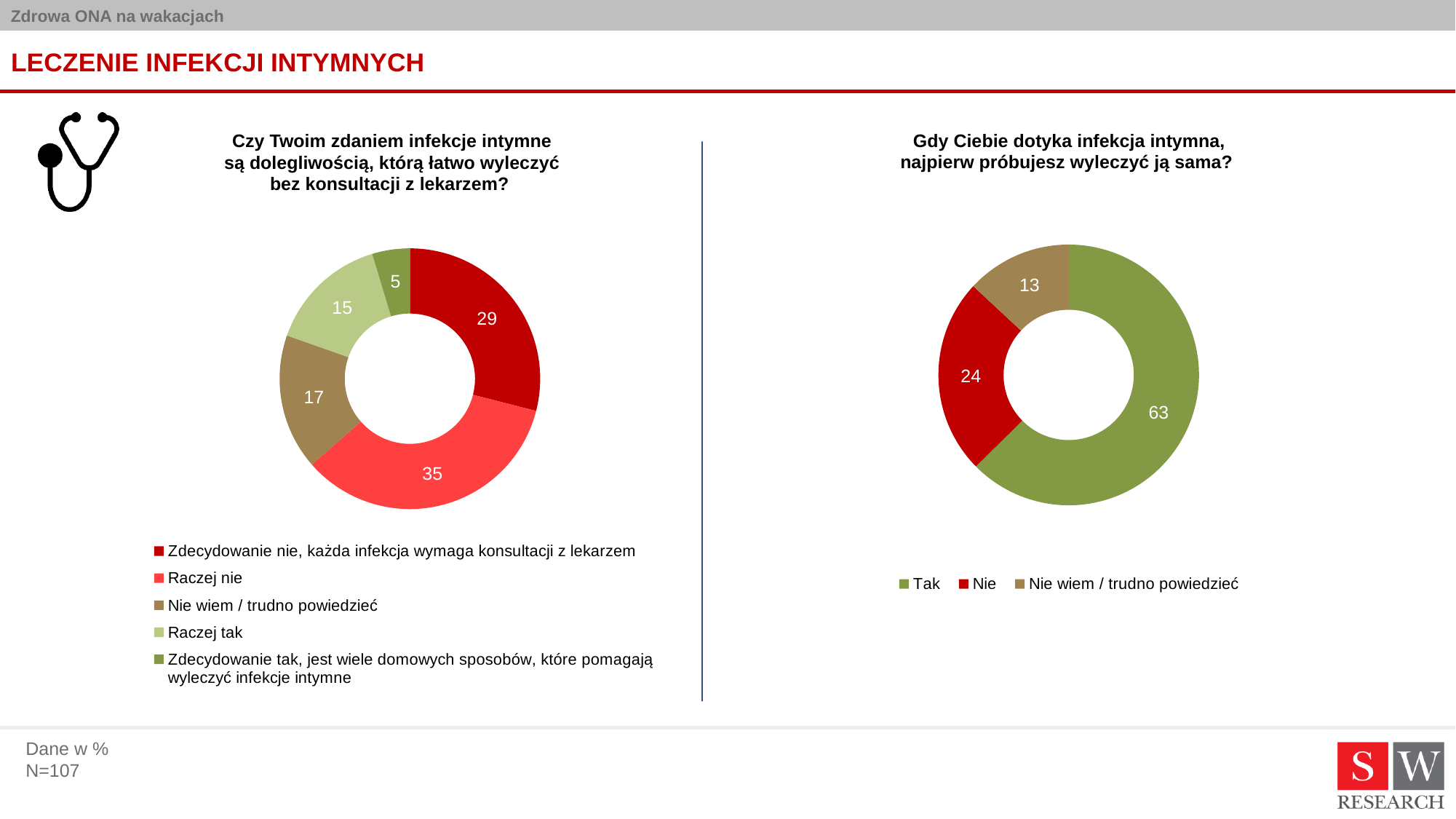
In the right chart, what is the value for "Nie wiem / trudno powiedzieć"? 13 In the left chart, what is the value for "Zdecydowanie nie, każda infekcja wymaga konsultacji z lekarzem"? 29 In the left chart, which category has the highest value? Raczej nie In the left chart, how many categories does the legend list? 5 In the right chart, what is the difference between "Tak" and "Nie"? 39 In the right chart, which is larger, "Tak" or "Nie"? Tak In the left chart ("Czy Twoim zdaniem infekcje intymne są dolegliwością, którą łatwo wyleczyć bez konsultacji z lekarzem?"), what is the value for "Raczej nie"? 35 In the right chart, what colour is the "Nie" slice? Red In the right chart ("Gdy Ciebie dotyka infekcja intymna, najpierw próbujesz wyleczyć ją sama?"), what is the value for "Tak"? 63 What kind of chart is the right chart? Doughnut chart In the left chart, what is the difference between "Nie wiem / trudno powiedzieć" and "Raczej tak"? 2 In the left chart, which category has the lowest value? Zdecydowanie tak, jest wiele domowych sposobów, które pomagają wyleczyć infekcje intymne